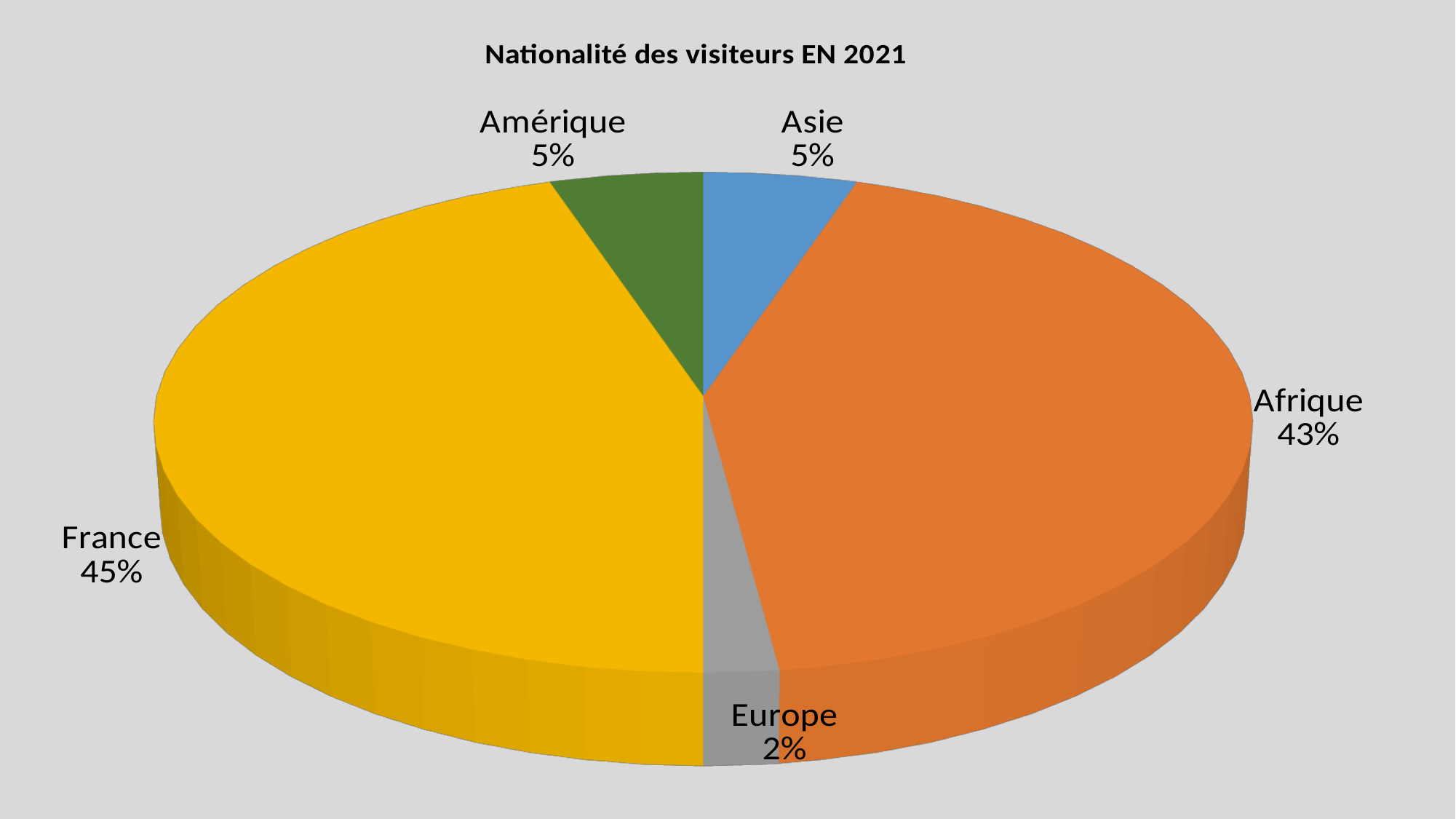
What is the title of the chart? Nationalité des visiteurs EN 2021 What kind of chart is shown on the slide? Pie chart What is the difference in percentage points between the France and Afrique shares? 2 Which nationality has the smallest share of visitors in 2021? Europe What share of visitors in 2021 came from Asie? 5% Which has a larger share of visitors, Afrique or Europe? Afrique What share of visitors in 2021 came from France? 45% What share of visitors in 2021 came from Afrique? 43% Which nationality has the largest share of visitors in 2021? France How many nationality categories are shown in the pie chart? 5